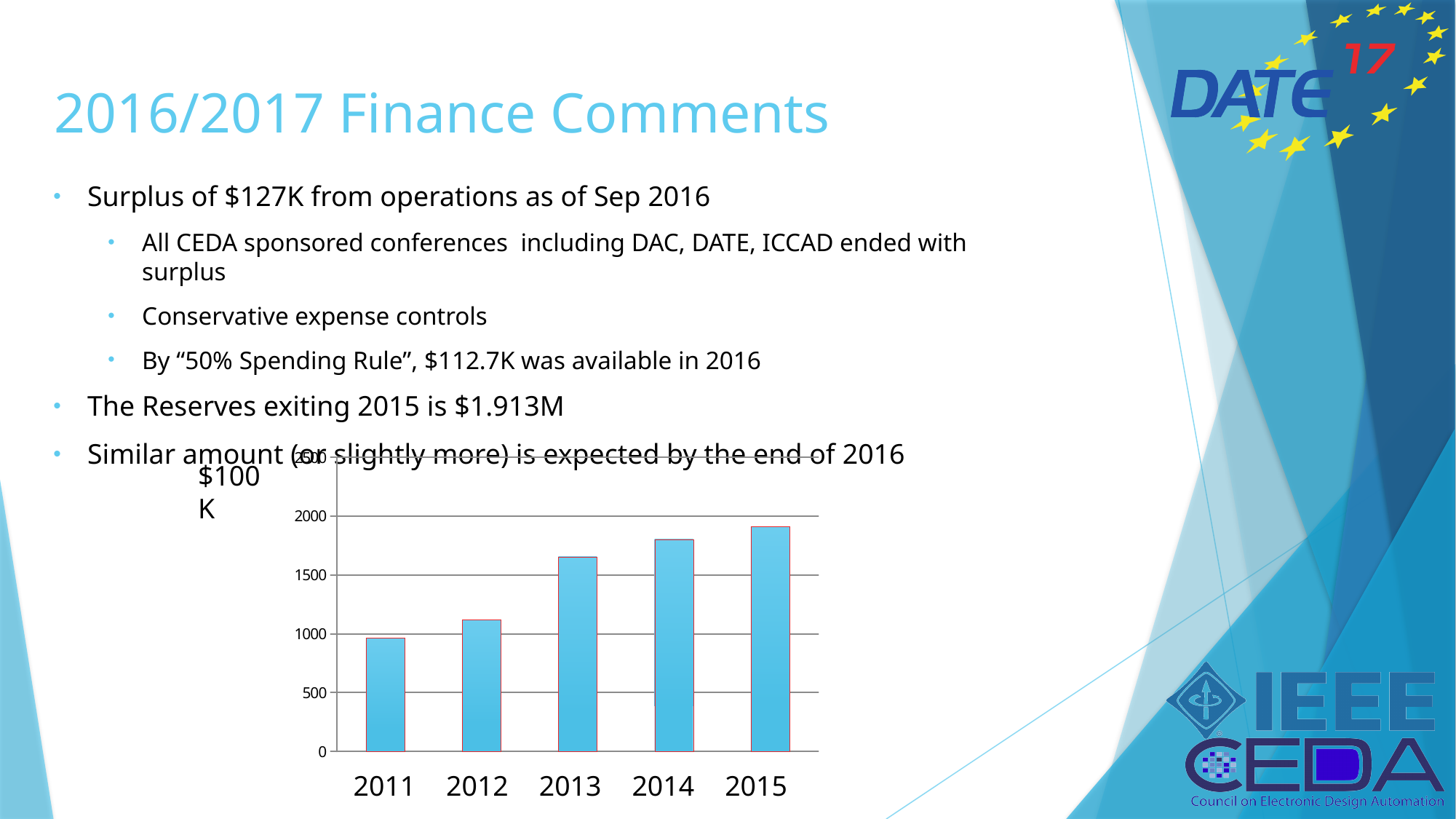
Which year has the highest bar in the chart? 2015 Is the value for 2012 greater or less than 1000? greater Which year has the lowest bar in the chart? 2011 How many years are shown on the x axis of the chart? 5 Do the bar values rise or fall from 2011 to 2015? rise Is the value for 2015 greater or less than 2000? less Which is larger, the value for 2013 or the value for 2014? 2014 What kind of chart is shown on the slide? bar chart Is the value for 2013 greater or less than 1500? greater What label is shown next to the vertical axis of the chart? $100 K Which is larger, the value for 2011 or the value for 2012? 2012